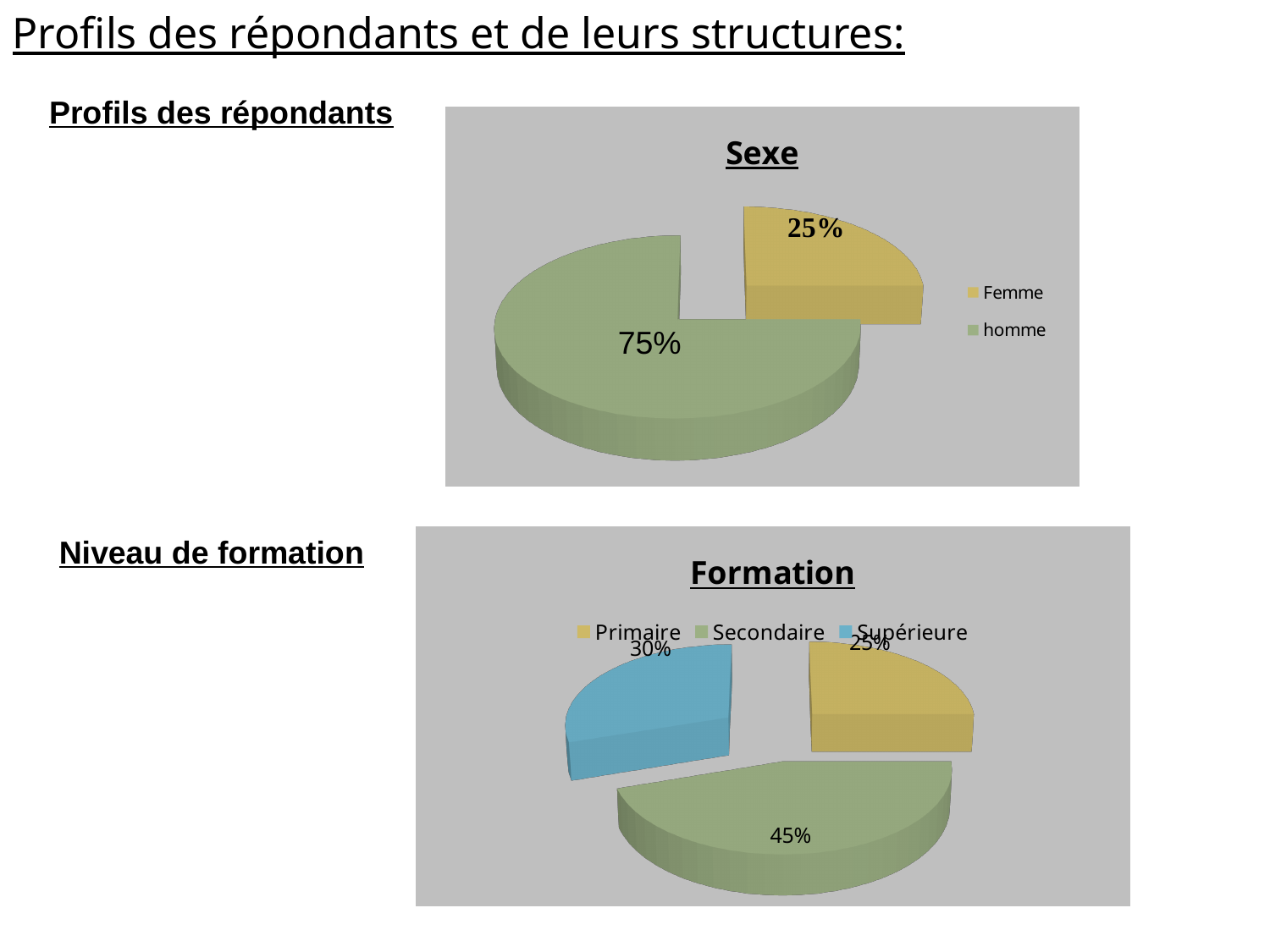
In the "Sexe" chart, what share of respondents are Femme? 25% In the "Formation" chart, what share is Supérieure? 30% In the "Sexe" chart, what is the difference between the homme and Femme shares? 50% How many categories does the "Formation" chart show? 3 In the "Formation" chart, which category has the smallest slice? Primaire How many entries does the legend of the "Sexe" chart list? 2 In the "Sexe" chart, which category has the largest slice? homme In the "Formation" chart, what share is Secondaire? 45% In the "Sexe" chart, what share of respondents are homme? 75% In the "Formation" chart, which is larger, Supérieure or Primaire? Supérieure What kind of chart is the "Sexe" chart? Pie chart In the "Formation" chart, what share is Primaire? 25%